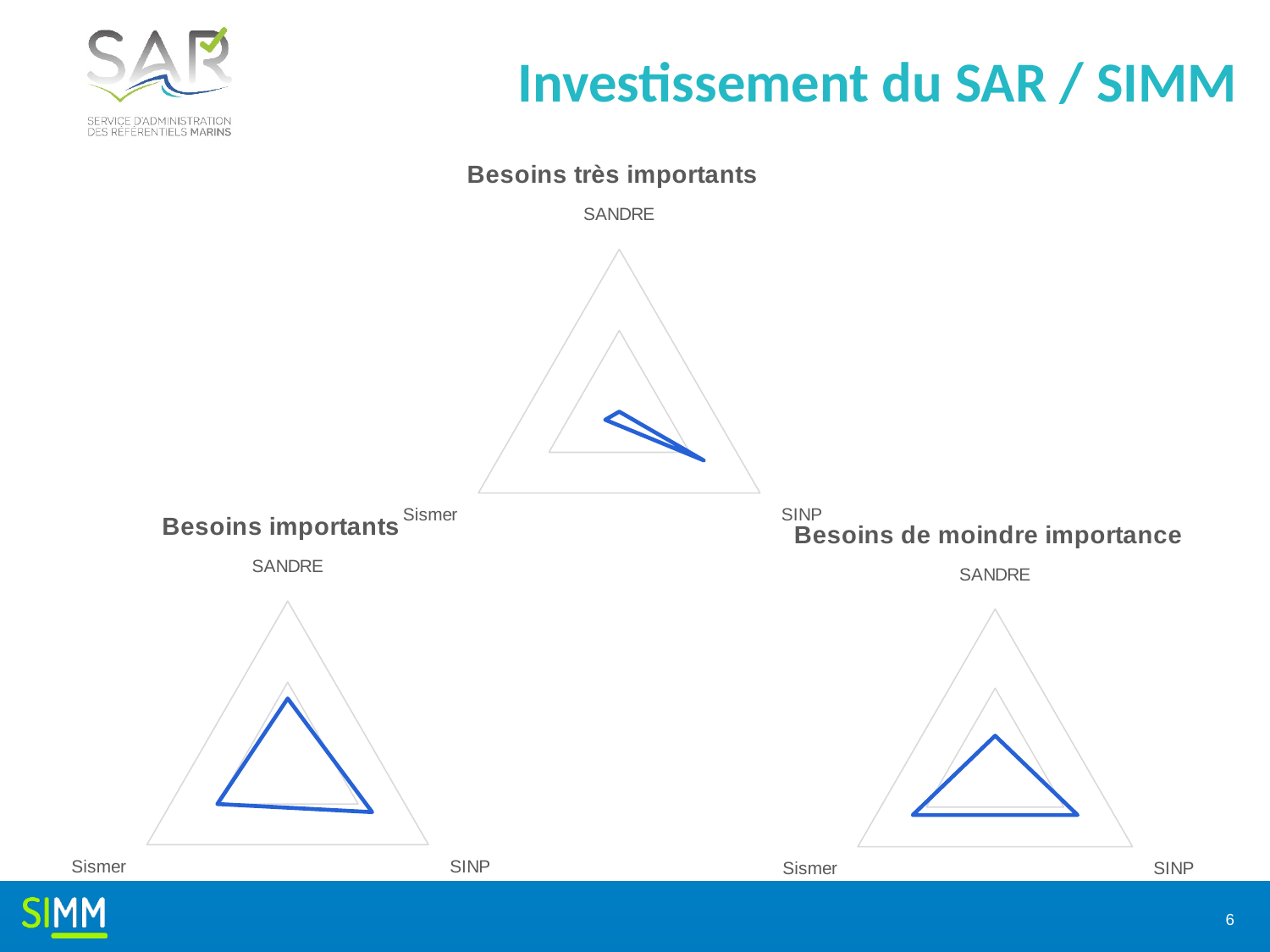
In the "Besoins très importants" chart, which is larger, the value for SINP or the value for SANDRE? SINP What kind of chart is "Besoins très importants"? Radar chart What are the three axis labels used in the "Besoins importants" chart? SANDRE, Sismer, SINP How many charts are shown on the slide? 3 In the "Besoins très importants" chart, which category has the highest value? SINP In the "Besoins très importants" chart, which category has the lowest value? SANDRE What is the title of the chart in the bottom-left of the slide? Besoins importants In the "Besoins de moindre importance" chart, which is larger, the value for Sismer or the value for SANDRE? Sismer In the "Besoins de moindre importance" chart, which category has the lowest value? SANDRE What kind of chart is "Besoins de moindre importance"? Radar chart In the "Besoins très importants" chart, how many categories (axes) are plotted? 3